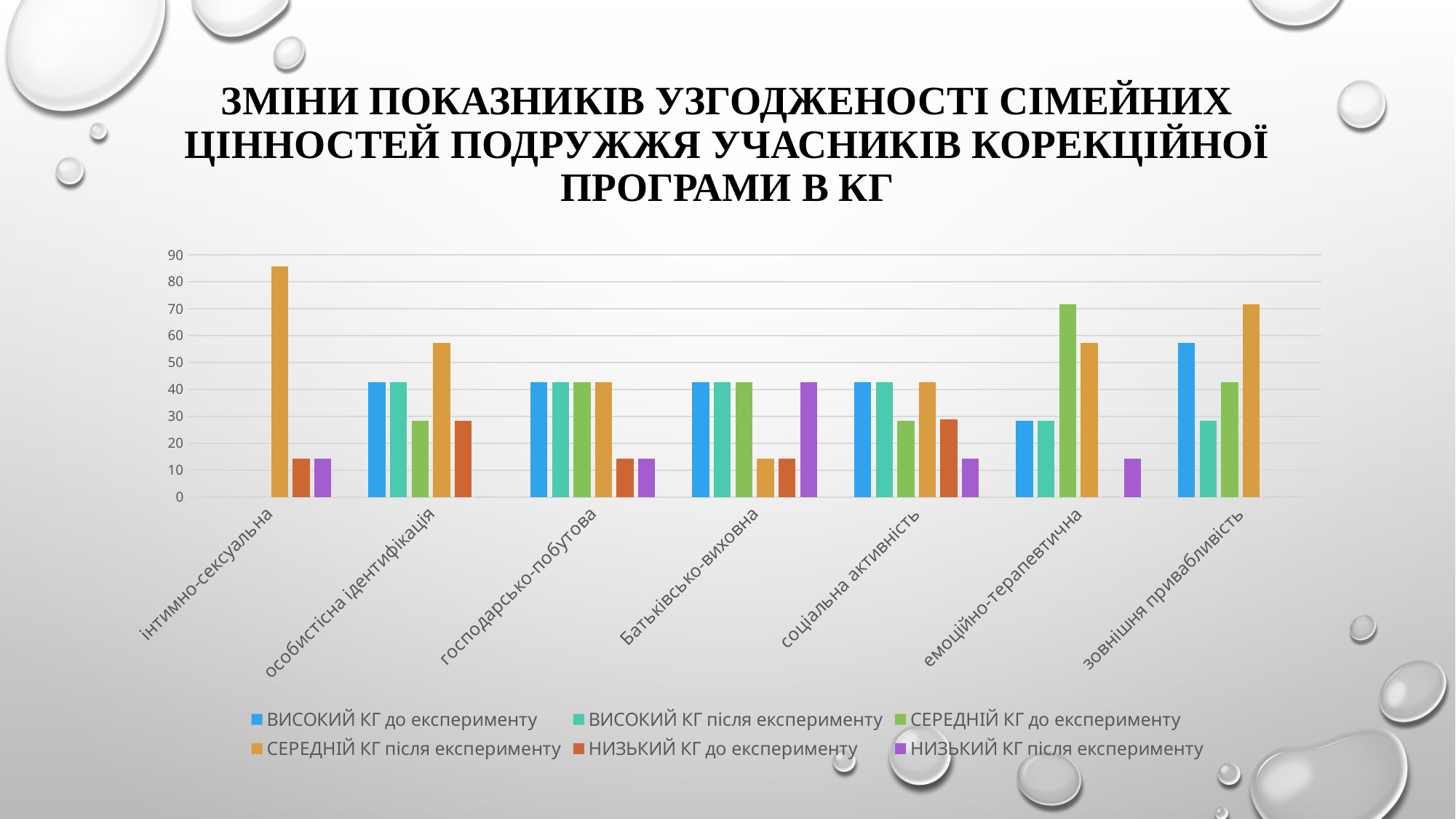
For the series ВИСОКИЙ КГ до експерименту, which category has the highest value? зовнішня привабливість Is the value for СЕРЕДНІЙ КГ після експерименту in the інтимно-сексуальна category greater or less than 80? greater What kind of chart is shown on the slide? bar chart Is the value for НИЗЬКИЙ КГ після експерименту in the господарсько-побутова category greater or less than 20? less How many series does the chart legend list? 6 In the особистісна ідентифікація category, which is larger: СЕРЕДНІЙ КГ до експерименту or СЕРЕДНІЙ КГ після експерименту? СЕРЕДНІЙ КГ після експерименту Is the value for ВИСОКИЙ КГ до експерименту in the зовнішня привабливість category greater or less than 50? greater How many categories are shown along the x axis of the chart? 7 Which category has the tallest bar in the whole chart? інтимно-сексуальна In the батьківсько-виховна category, which is larger: НИЗЬКИЙ КГ до експерименту or НИЗЬКИЙ КГ після експерименту? НИЗЬКИЙ КГ після експерименту For the series СЕРЕДНІЙ КГ після експерименту, which category has the lowest value? батьківсько-виховна